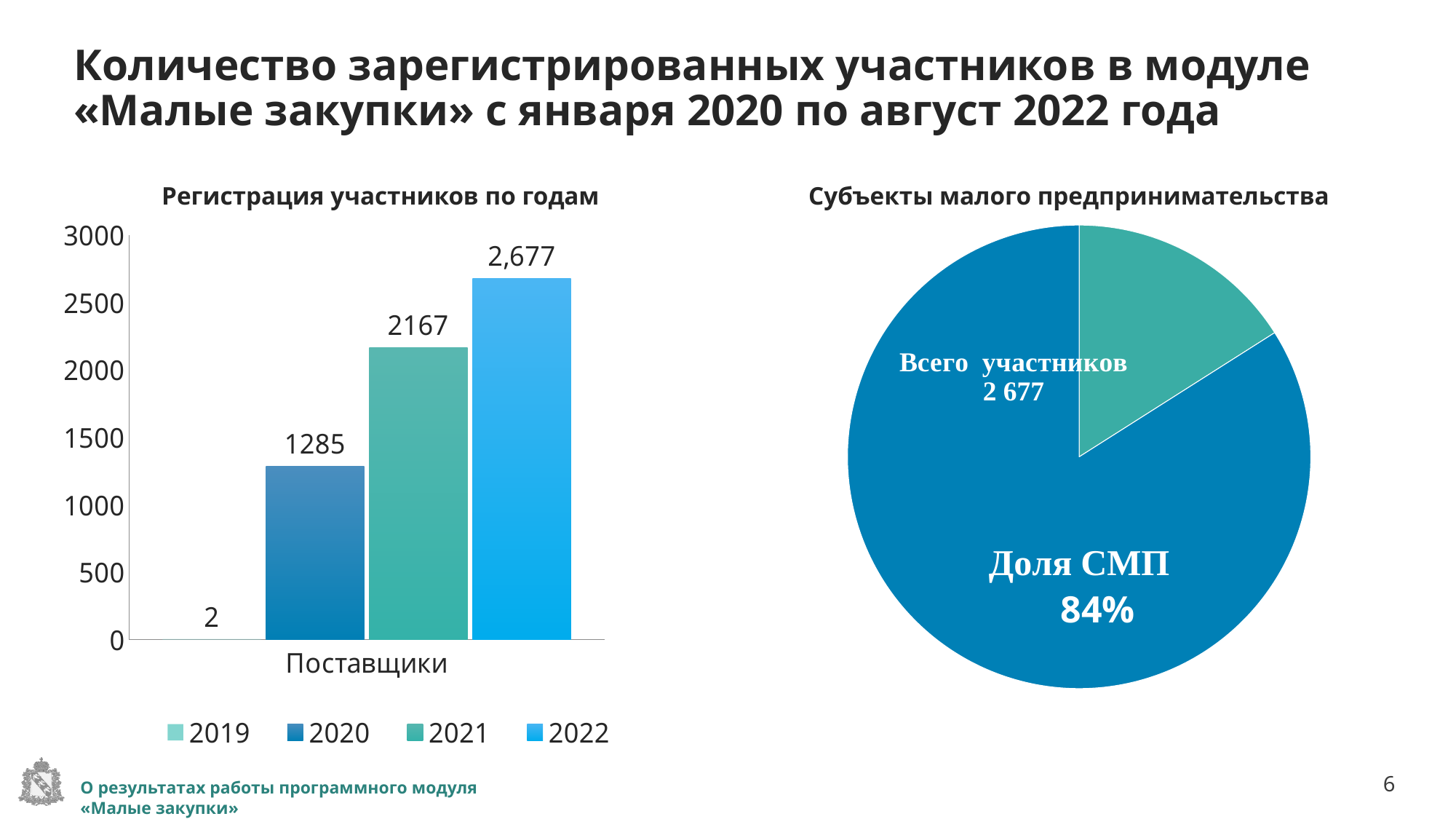
In the chart titled «Регистрация участников по годам», which year has the highest value? 2022 In the chart titled «Регистрация участников по годам», which is larger: the value for 2020 or the value for 2021? 2021 In the chart titled «Регистрация участников по годам», what is the difference between the values for 2021 and 2020? 882 What kind of chart is the chart titled «Субъекты малого предпринимательства»? pie chart In the chart titled «Регистрация участников по годам», what is the value for 2020? 1285 In the chart titled «Регистрация участников по годам», how many series does the legend list? 4 In the chart titled «Регистрация участников по годам», what is the value for 2019? 2 In the chart titled «Регистрация участников по годам», what is the value for 2021? 2167 In the chart titled «Субъекты малого предпринимательства», what share is labelled «Доля СМП»? 84% In the chart titled «Регистрация участников по годам», what is the value for 2022? 2,677 In the chart titled «Регистрация участников по годам», which year has the lowest value? 2019 What kind of chart is the chart titled «Регистрация участников по годам»? bar chart